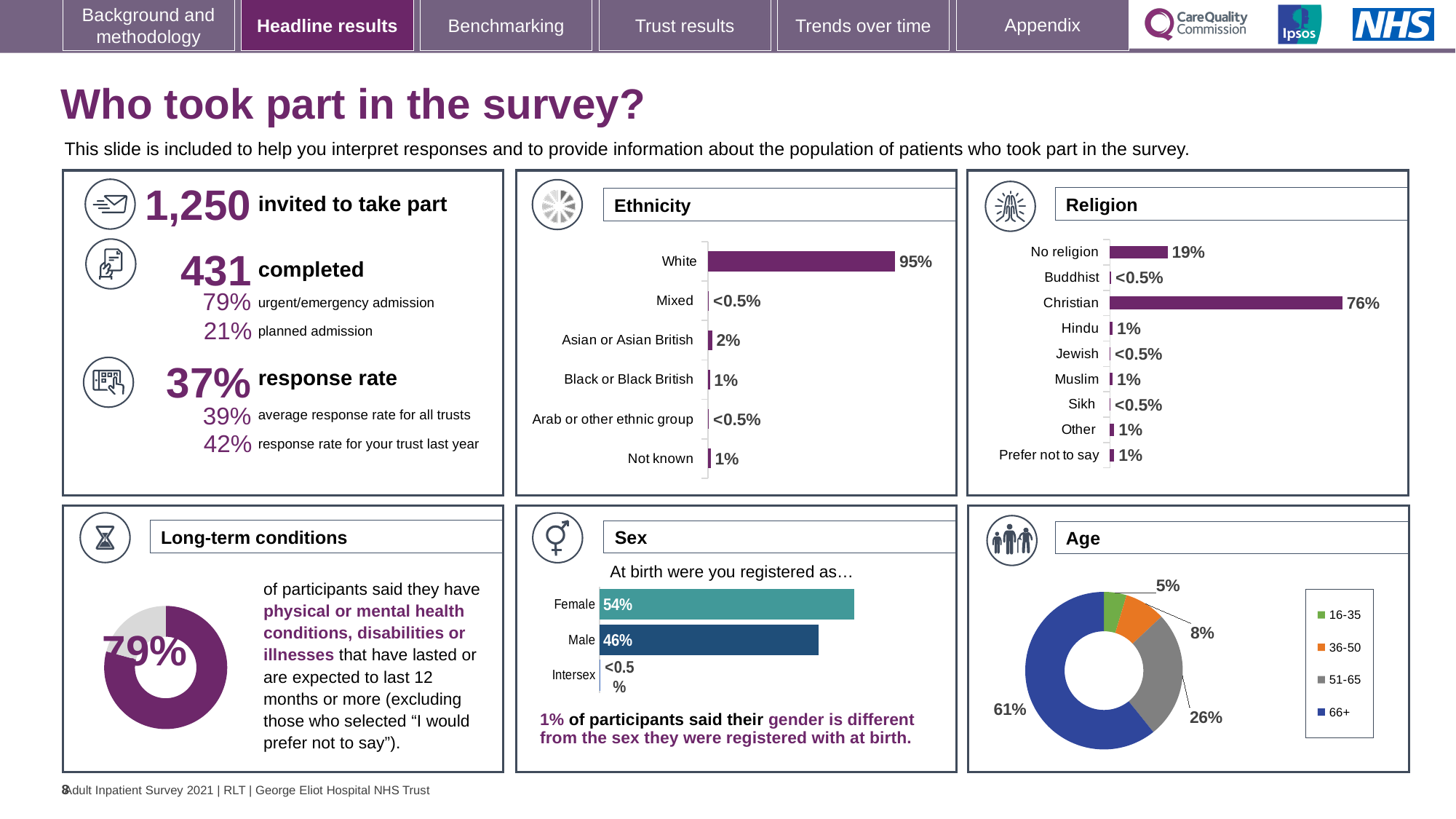
In the Ethnicity chart, what is the value for Asian or Asian British? 2% How many categories are shown in the Ethnicity chart? 6 In the Sex chart, which is larger, Female or Male? Female In the Religion chart, what is the difference between the Christian and No religion percentages? 57% In the Age chart, what share of participants were aged 66+? 61% In the Religion chart, what percentage of participants were Christian? 76% In the Ethnicity chart, what percentage of participants were White? 95% What kind of chart is used for the Age breakdown? Doughnut chart In the Sex chart, what percentage of participants were registered as Female at birth? 54% How many age groups does the legend of the Age chart list? 4 In the Ethnicity chart, which ethnic group has the highest percentage? White How many categories are shown in the Religion chart? 9